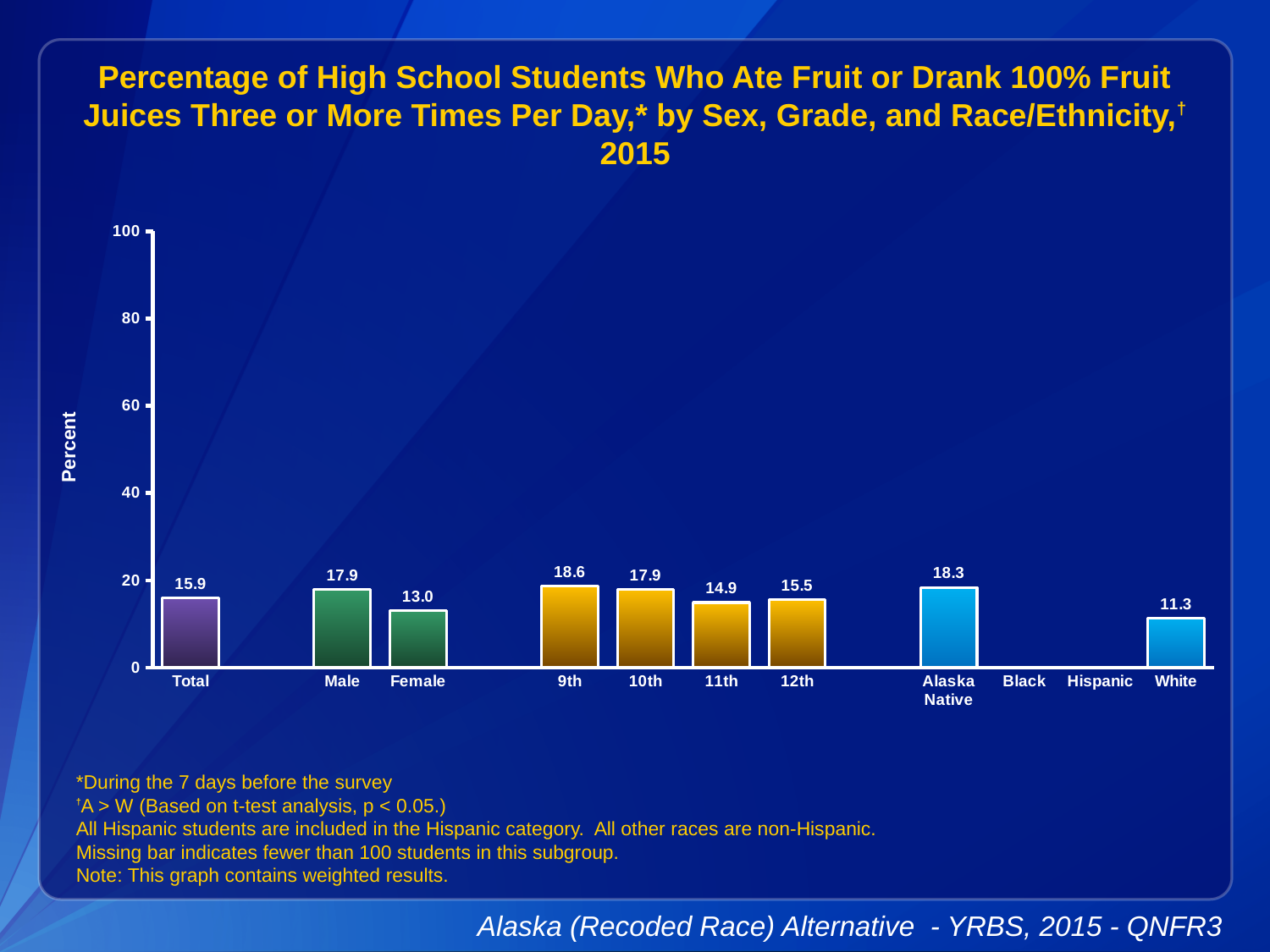
Which is larger, the value for 11th grade or 12th grade? 12th What is the label on the y axis? Percent What is the value for Total? 15.9 Is the value for 10th grade greater or less than 20? less What is the value for 9th grade? 18.6 How many categories have a bar plotted? 9 What is the value for Alaska Native? 18.3 Which category with a plotted bar has the lowest value? White What kind of chart is shown? bar chart Which category has the highest value? 9th What is the value for Female? 13.0 What is the difference between the Male and Female values? 4.9